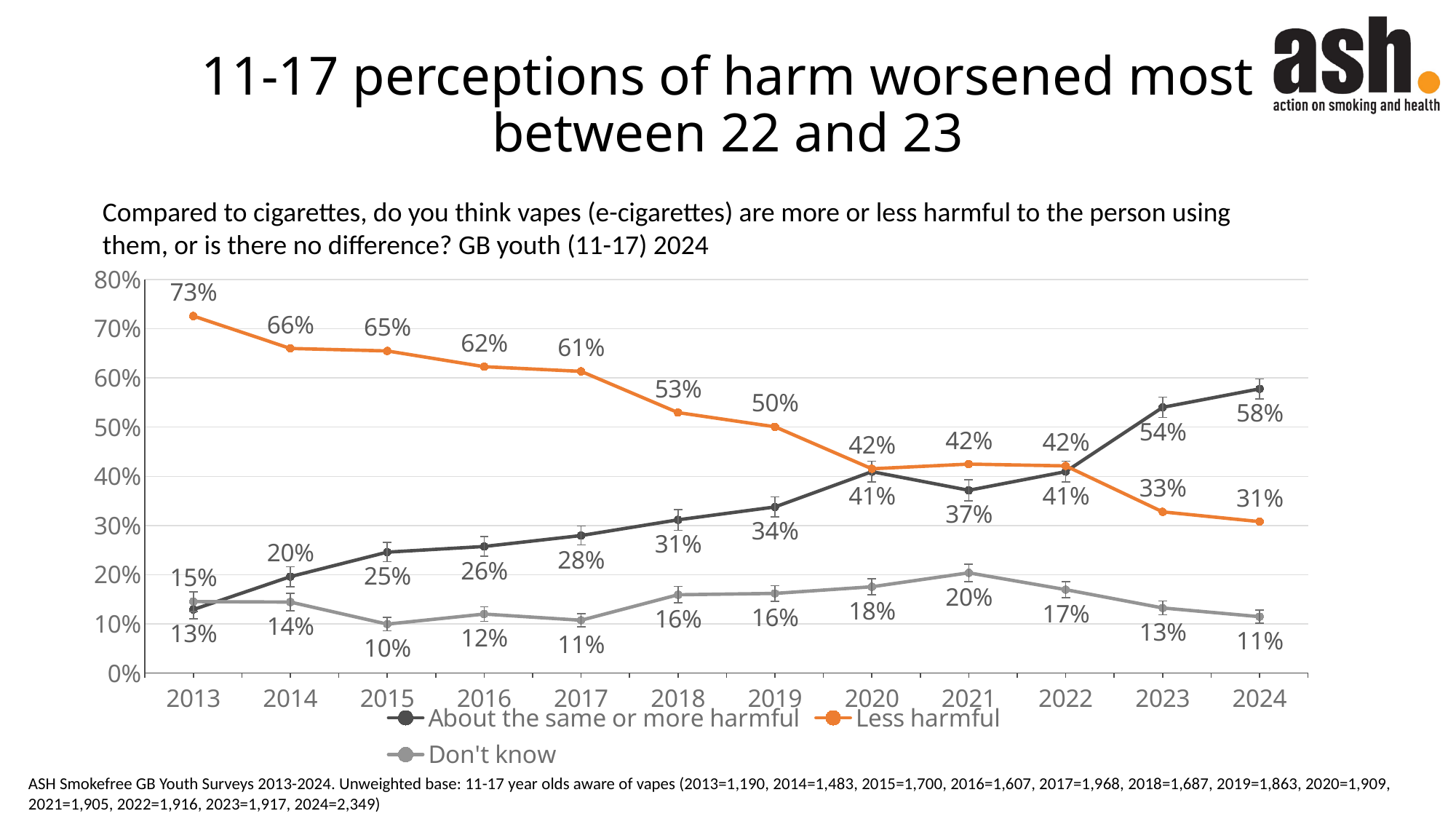
How many series does the legend list? 3 What percentage of 11-17 year olds said vapes were less harmful in 2013? 73% By how many percentage points did 'About the same or more harmful' rise from 2013 to 2024? 45 percentage points In which year was the 'Don't know' series at its lowest? 2015 What is the value for 'Don't know' in 2021? 20% What kind of chart is shown on the slide? Line chart What is the value for 'About the same or more harmful' in 2024? 58% Does the 'Less harmful' series generally rise or fall from 2013 to 2024? Fall How many years are plotted along the x axis? 12 By how many percentage points did 'Less harmful' fall between 2022 and 2023? 9 percentage points In 2019, which was larger: 'Less harmful' or 'About the same or more harmful'? Less harmful In which year was the 'Less harmful' series at its highest? 2013